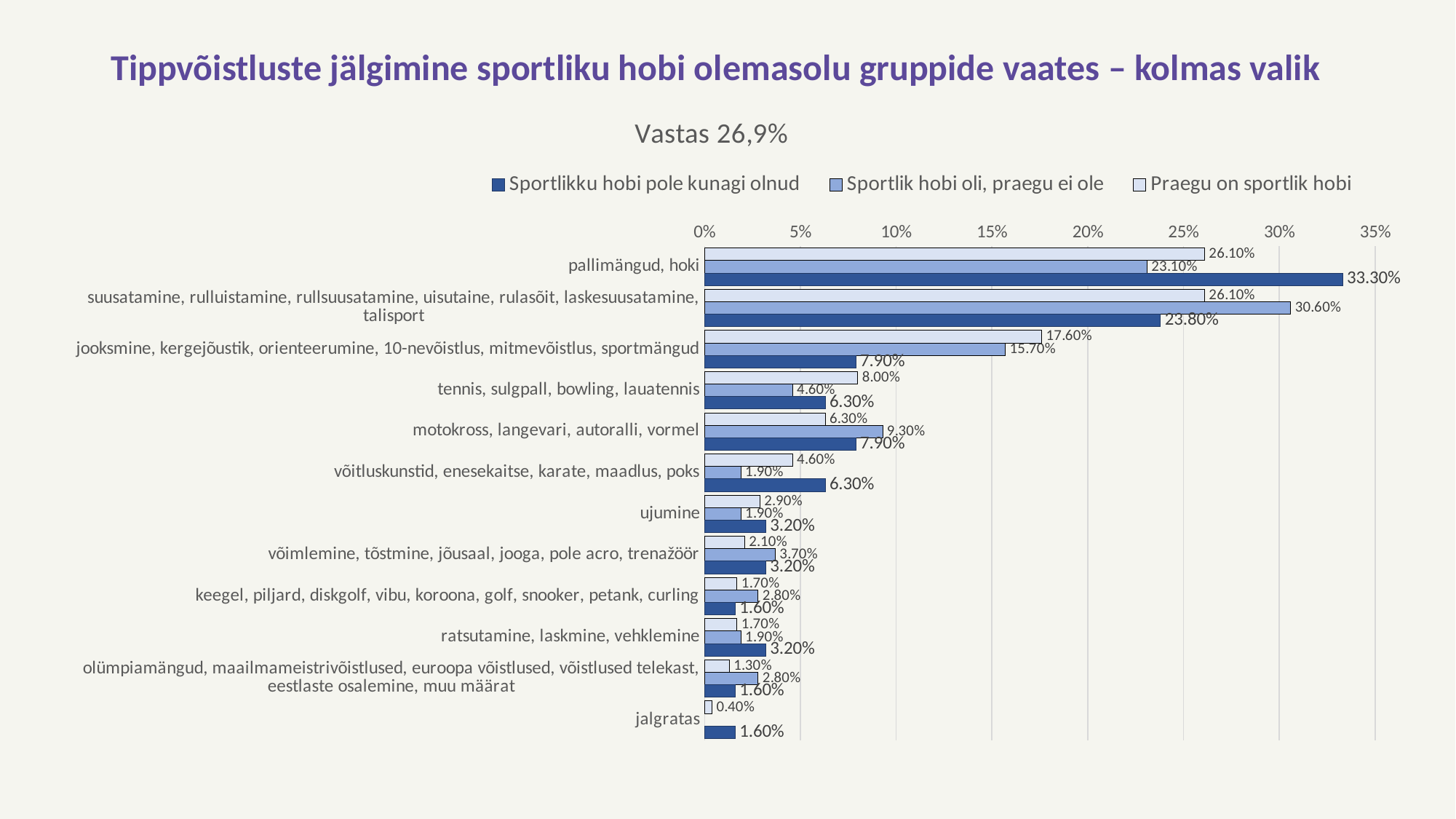
What is the value for 'pallimängud, hoki' in the 'Sportlikku hobi pole kunagi olnud' series? 33.30% What is the value for 'jooksmine, kergejõustik, orienteerumine, 10-nevõistlus, mitmevõistlus, sportmängud' in the 'Praegu on sportlik hobi' series? 17.60% What is the difference between the 'Sportlikku hobi pole kunagi olnud' and 'Sportlik hobi oli, praegu ei ole' values for 'pallimängud, hoki'? 10.20% What is the subtitle shown above the legend of the chart? Vastas 26,9% For 'motokross, langevari, autoralli, vormel', which series has the larger value: 'Sportlik hobi oli, praegu ei ole' or 'Praegu on sportlik hobi'? Sportlik hobi oli, praegu ei ole Which category has the highest value in the 'Sportlikku hobi pole kunagi olnud' series? pallimängud, hoki Which category has the lowest value in the 'Praegu on sportlik hobi' series? jalgratas What is the value for 'suusatamine, rulluistamine, rullsuusatamine, uisutaine, rulasõit, laskesuusatamine, talisport' in the 'Sportlik hobi oli, praegu ei ole' series? 30.60% What type of chart is shown on the slide? bar chart How many categories are shown on the chart? 12 How many series does the legend list? 3 Is the value for 'suusatamine, rulluistamine, rullsuusatamine, uisutaine, rulasõit, laskesuusatamine, talisport' in the 'Sportlikku hobi pole kunagi olnud' series greater or less than 25%? less